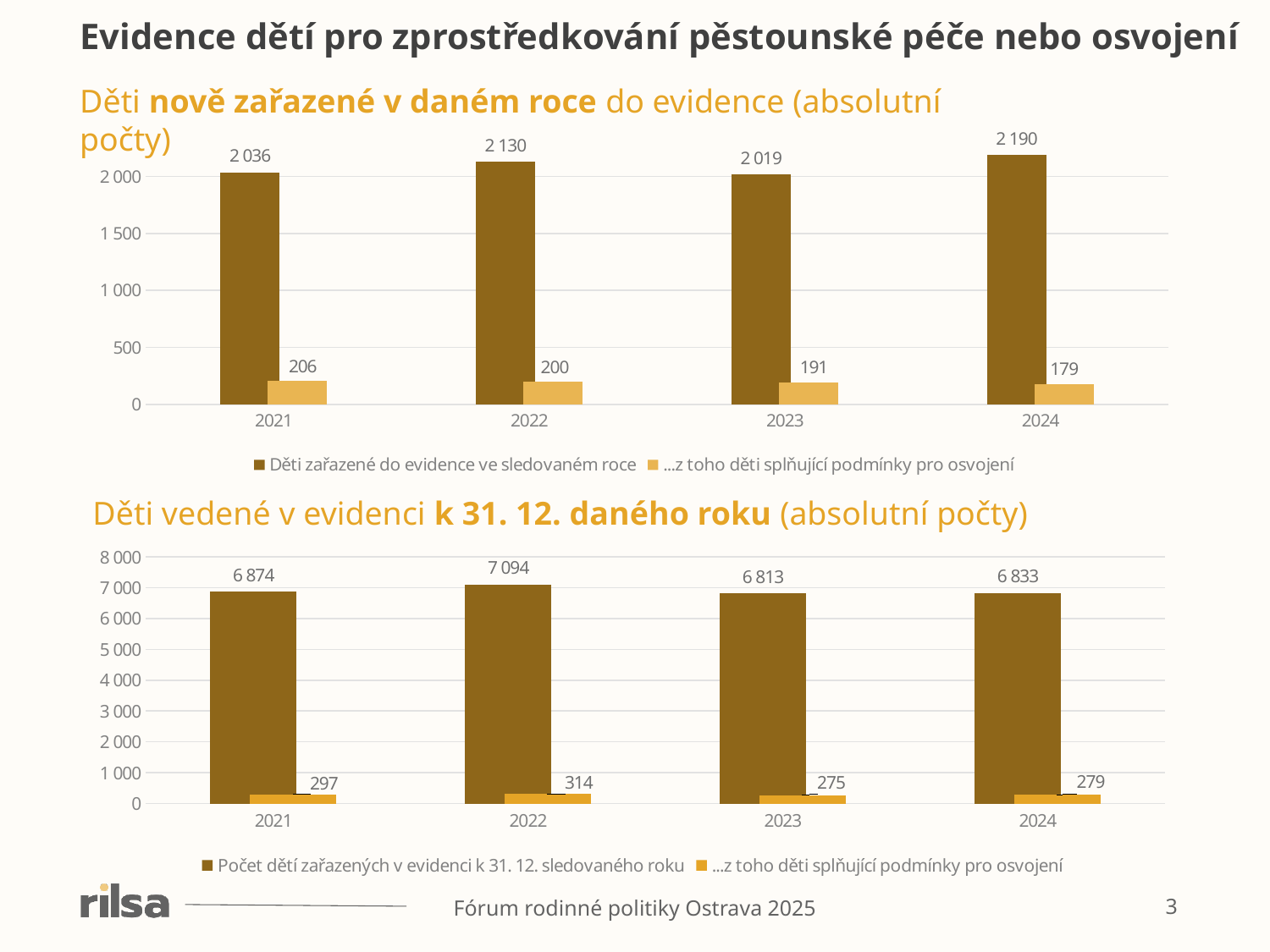
In the top chart (Děti nově zařazené v daném roce do evidence), what is the value for '...z toho děti splňující podmínky pro osvojení' in 2024? 179 In the top chart (Děti nově zařazené v daném roce do evidence), does the value for '...z toho děti splňující podmínky pro osvojení' rise or fall from 2021 to 2024? fall In the bottom chart (Děti vedené v evidenci k 31. 12. daného roku), what is the difference between the 2022 and 2023 values for '...z toho děti splňující podmínky pro osvojení'? 39 In the top chart (Děti nově zařazené v daném roce do evidence), what is the difference between the 2024 and 2023 values for 'Děti zařazené do evidence ve sledovaném roce'? 171 In the bottom chart (Děti vedené v evidenci k 31. 12. daného roku), what is the value for 'Počet dětí zařazených v evidenci k 31. 12. sledovaného roku' in 2021? 6 874 In the top chart (Děti nově zařazené v daném roce do evidence), what is the value for 'Děti zařazené do evidence ve sledovaném roce' in 2022? 2 130 What kind of chart is the top chart (Děti nově zařazené v daném roce do evidence)? bar chart In the top chart (Děti nově zařazené v daném roce do evidence), which year has the lowest value for '...z toho děti splňující podmínky pro osvojení'? 2024 In the bottom chart (Děti vedené v evidenci k 31. 12. daného roku), how many series does the legend list? 2 In the bottom chart (Děti vedené v evidenci k 31. 12. daného roku), which year has the highest value for 'Počet dětí zařazených v evidenci k 31. 12. sledovaného roku'? 2022 In the bottom chart (Děti vedené v evidenci k 31. 12. daného roku), what is the value for '...z toho děti splňující podmínky pro osvojení' in 2022? 314 In the top chart (Děti nově zařazené v daném roce do evidence), which year has the highest value for 'Děti zařazené do evidence ve sledovaném roce'? 2024